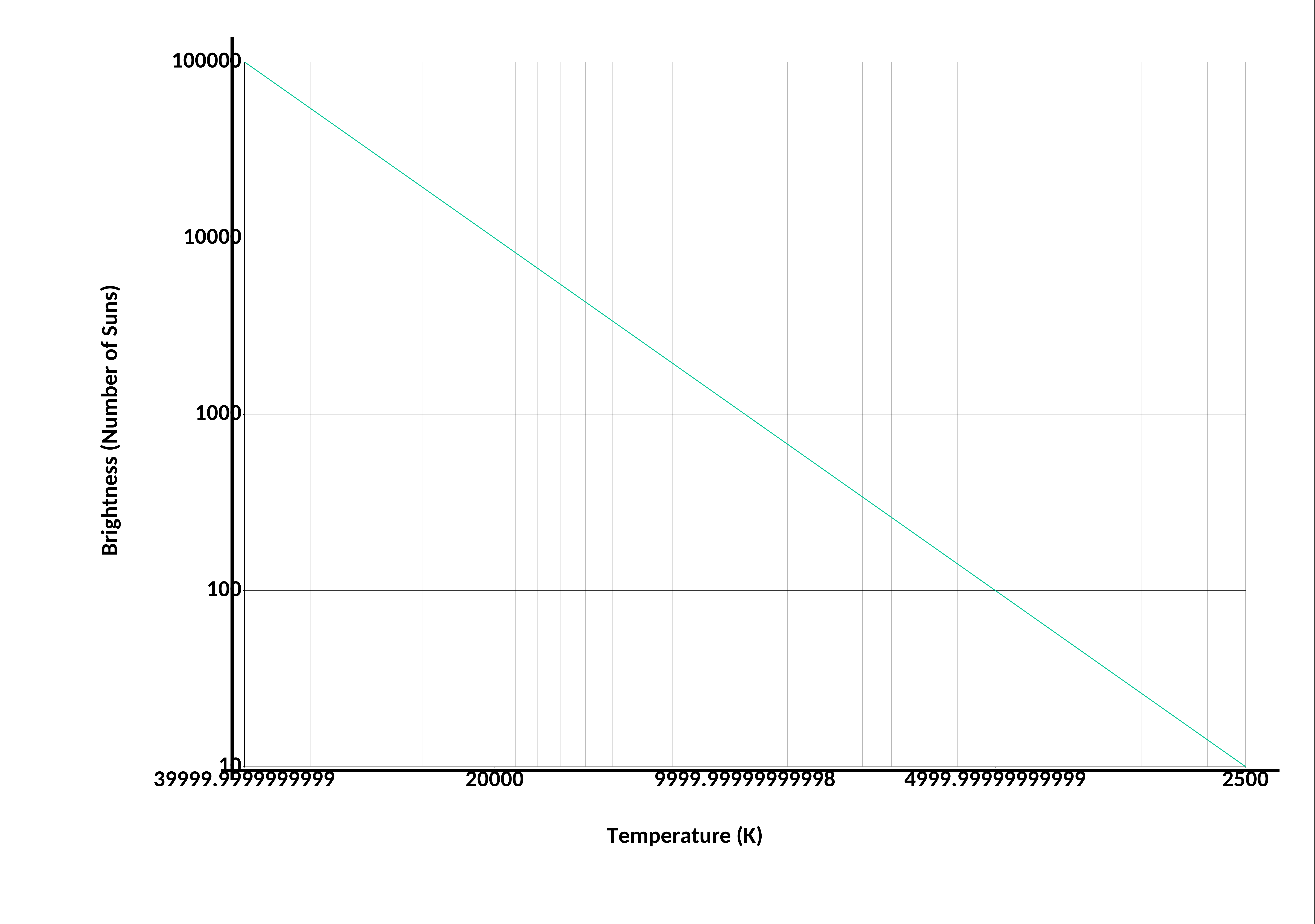
What is the title of the x axis? Temperature (K) Which temperature has the higher brightness, 20000 K or 2500 K? 20000 K What is the brightness (Number of Suns) at a temperature of 20000 K? 10000 What is the title of the y axis? Brightness (Number of Suns) Do the brightness values rise or fall moving left to right along the x axis? fall At which labelled temperature is the brightness lowest? 2500 How many tick labels are shown on the y axis? 5 Is the brightness at 20000 K greater or less than 1000? greater What kind of chart is shown on the slide? line chart What is the difference in brightness between 20000 K and 2500 K? 9990 Is the brightness at 4999.9999999999 K greater or less than 1000? less What is the brightness (Number of Suns) at a temperature of 2500 K? 10